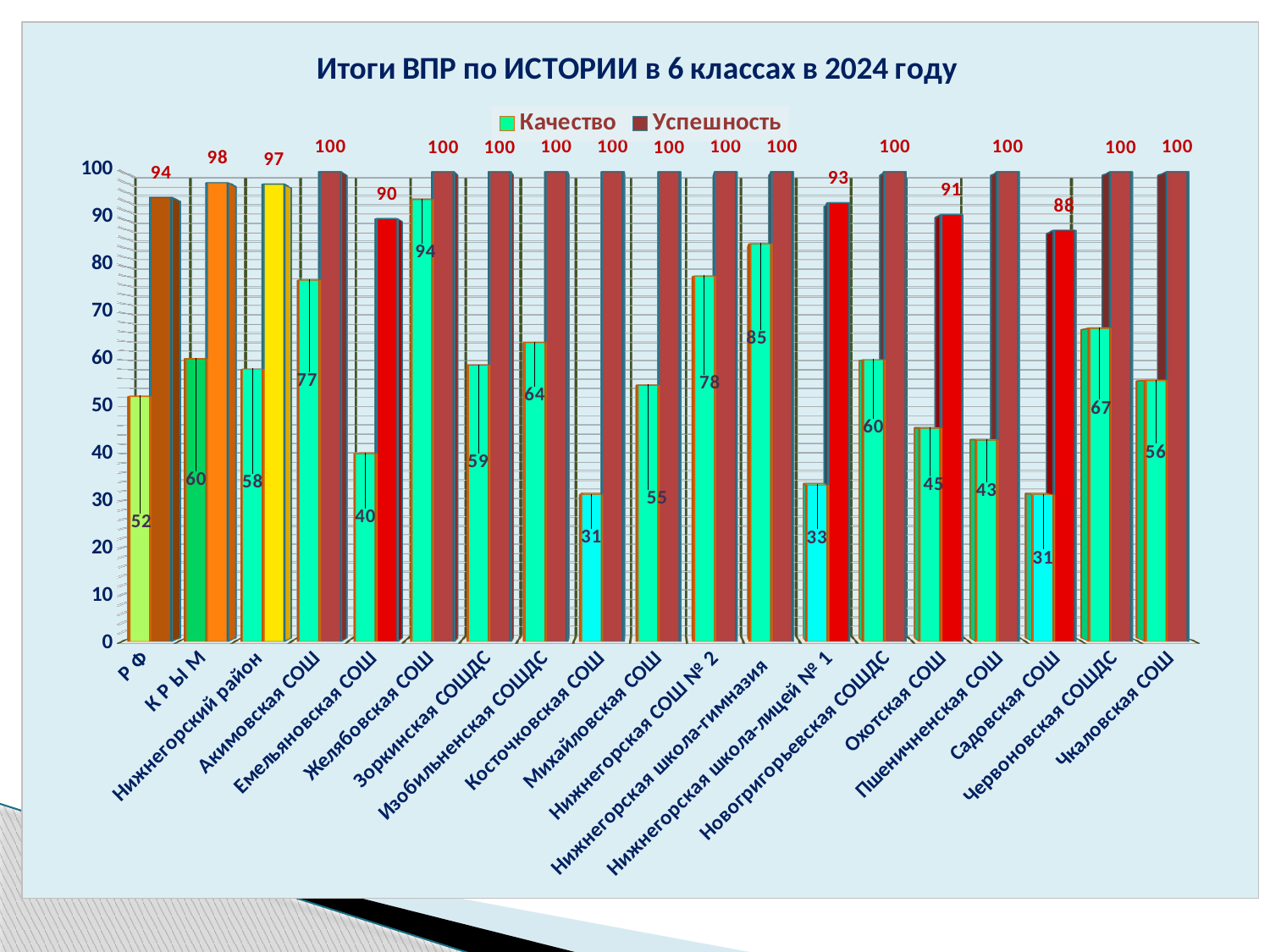
What is the title of the chart? Итоги ВПР по ИСТОРИИ в 6 классах в 2024 году Is the Качество value for Косточковская СОШ greater or less than 40? less How many series does the legend list? 2 What is the Качество value for Нижнегорская школа-гимназия? 85 What is the Качество value for Желябовская СОШ? 94 Which has the larger Качество value: Михайловская СОШ or Изобильненская СОШДС? Изобильненская СОШДС What kind of chart is shown on the slide? bar chart Which category has the lowest Успешность value? Садовская СОШ What is the difference between Успешность and Качество for Емельяновская СОШ? 50 How many categories are shown on the x axis? 19 What is the Успешность value for Садовская СОШ? 88 Which category has the highest Качество value? Желябовская СОШ